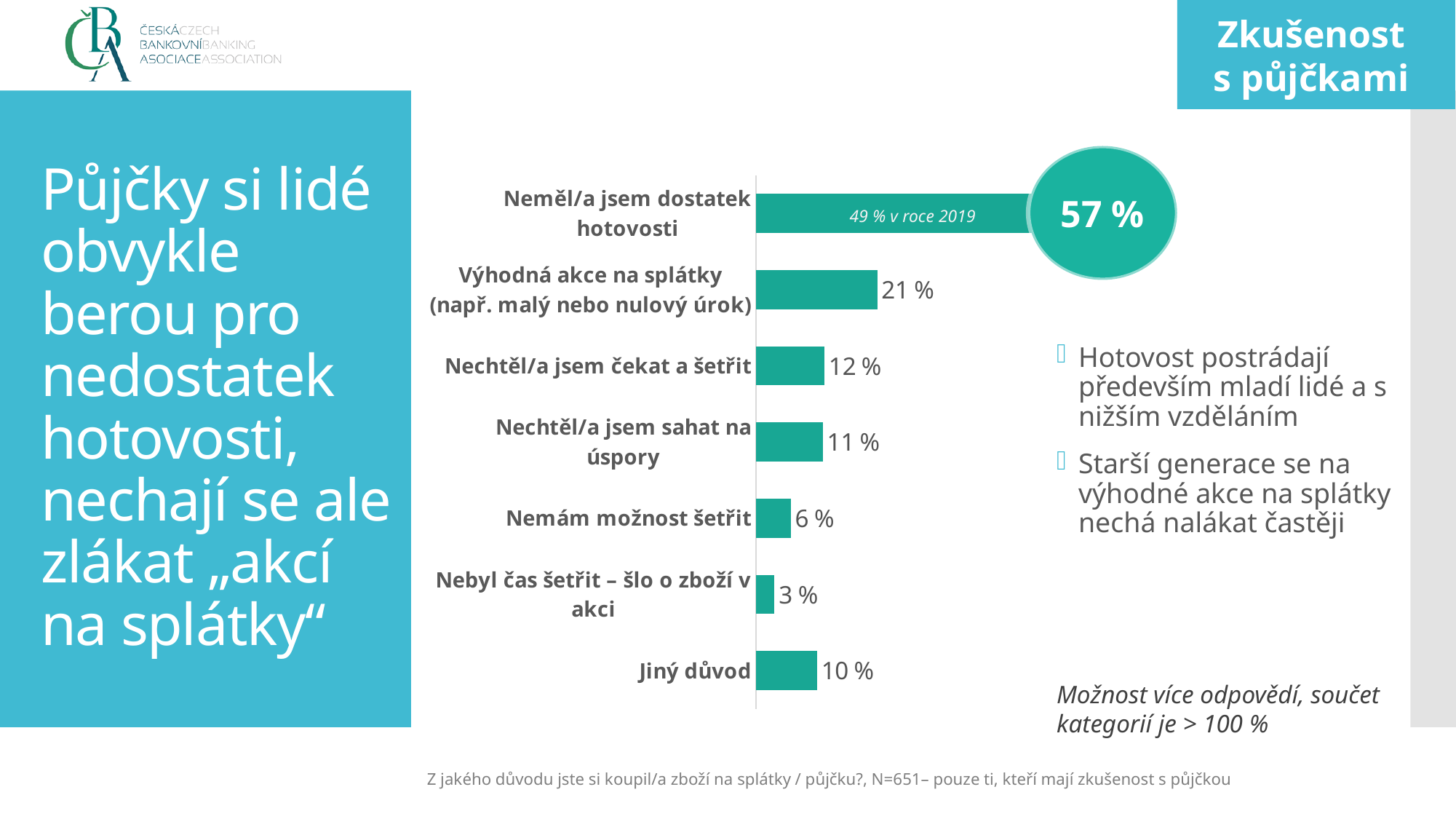
What is the value for "Výhodná akce na splátky (např. malý nebo nulový úrok)"? 21 % What kind of chart is shown on the slide? Bar chart What is the value for "Jiný důvod"? 10 % Which category has the highest value? Neměl/a jsem dostatek hotovosti What is the value for "Neměl/a jsem dostatek hotovosti"? 57 % Which category has the lowest value? Nebyl čas šetřit – šlo o zboží v akci How many categories does the chart show? 7 According to the annotation on the top bar, what was the value for "Neměl/a jsem dostatek hotovosti" in 2019? 49 % What is the value for "Nechtěl/a jsem sahat na úspory"? 11 % Which is larger, the value for "Jiný důvod" or the value for "Nemám možnost šetřit"? Jiný důvod What is the difference between the values for "Nechtěl/a jsem čekat a šetřit" and "Nemám možnost šetřit"? 6 % What is the difference between the values for "Neměl/a jsem dostatek hotovosti" and "Výhodná akce na splátky (např. malý nebo nulový úrok)"? 36 %